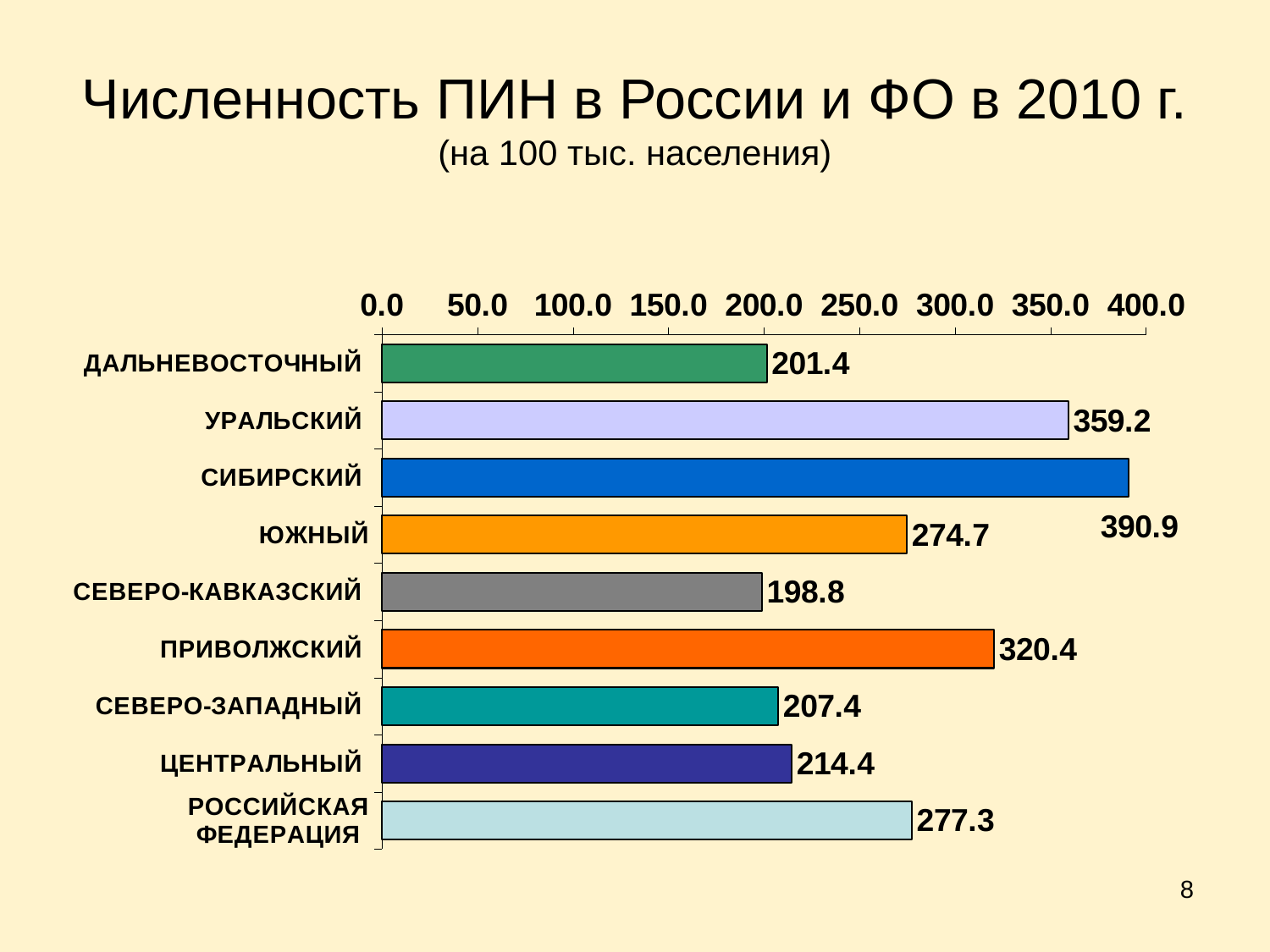
What is the value for Уральский? 359.2 What is the value for Приволжский? 320.4 What is the difference between the values for Сибирский and Уральский? 31.7 Which is larger, the value for Центральный or the value for Северо-Западный? Центральный What kind of chart is shown on the slide? bar chart What is the title of the chart on the slide? Численность ПИН в России и ФО в 2010 г. (на 100 тыс. населения) Which category has the lowest value? Северо-Кавказский Is the value for Приволжский greater or less than 300.0? greater How many categories are shown in the chart? 9 Which category has the highest value? Сибирский What is the difference between the values for Южный and Северо-Кавказский? 75.9 What is the value for Российская Федерация? 277.3